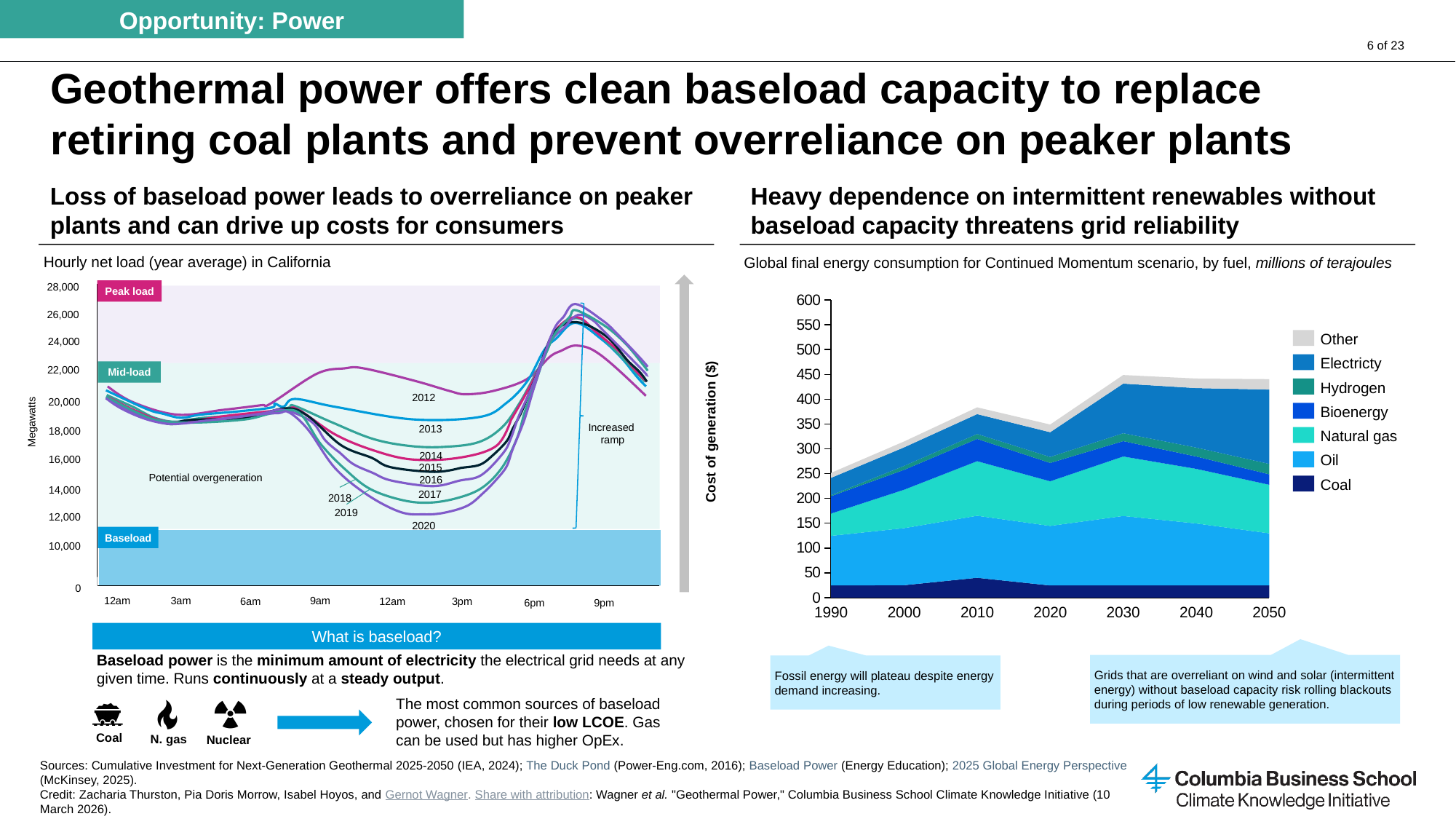
In the right chart, is the total energy consumption in 1990 greater or less than 300 million terajoules? less In the right chart, does total energy consumption rise or fall between 1990 and 2030? rise In the left chart, is the lowest point of the 2012 line greater or less than 20,000 megawatts? less In the left chart, how many years are plotted as lines? 9 What kind of chart is the right chart, 'Global final energy consumption for Continued Momentum scenario, by fuel'? stacked area chart What kind of chart is the left chart, 'Hourly net load (year average) in California'? line chart In the right chart, how many years are labelled on the x axis? 7 In the right chart, is the total energy consumption in 2030 greater or less than 400 million terajoules? greater In the left chart, what unit is shown on the y axis? Megawatts In the right chart, which fuel is shown in the lightest grey at the top of the stack? Other In the right chart, how many fuel categories does the legend list? 7